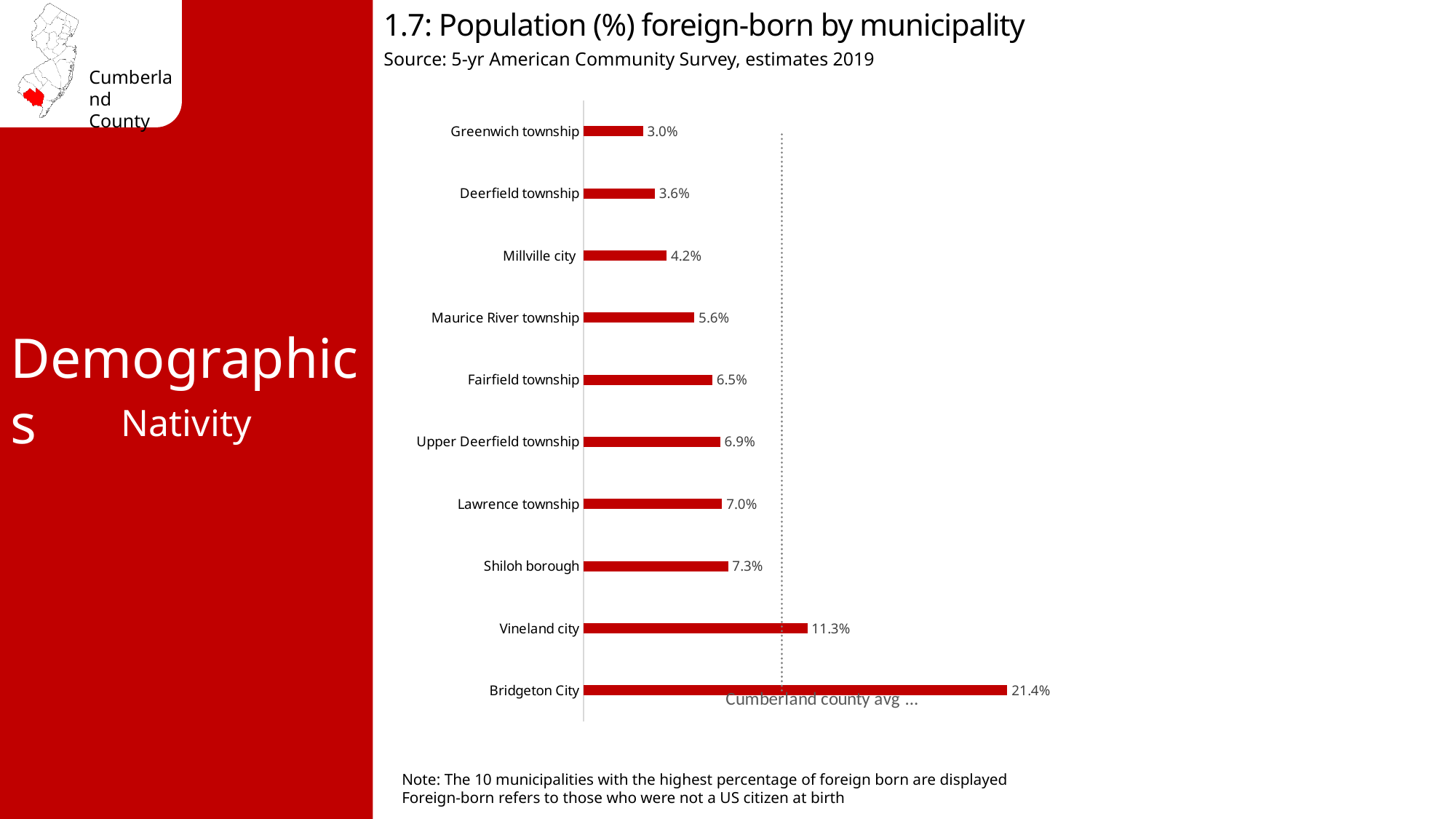
What is the difference in foreign-born percentage between Bridgeton City and Vineland city? 10.1% Which has a higher foreign-born percentage, Lawrence township or Millville city? Lawrence township What is the percentage of foreign-born population in Maurice River township? 5.6% Which has a higher foreign-born percentage, Fairfield township or Deerfield township? Fairfield township Which municipality has the lowest percentage of foreign-born population? Greenwich township How many municipalities are shown in the chart? 10 What is the percentage of foreign-born population in Upper Deerfield township? 6.9% What type of chart is used to show the foreign-born population by municipality? Bar chart What does the dotted vertical line in the chart represent? Cumberland county avg Which municipality has the highest percentage of foreign-born population? Bridgeton City What is the percentage of foreign-born population in Vineland city? 11.3% What is the difference in foreign-born percentage between Shiloh borough and Millville city? 3.1%